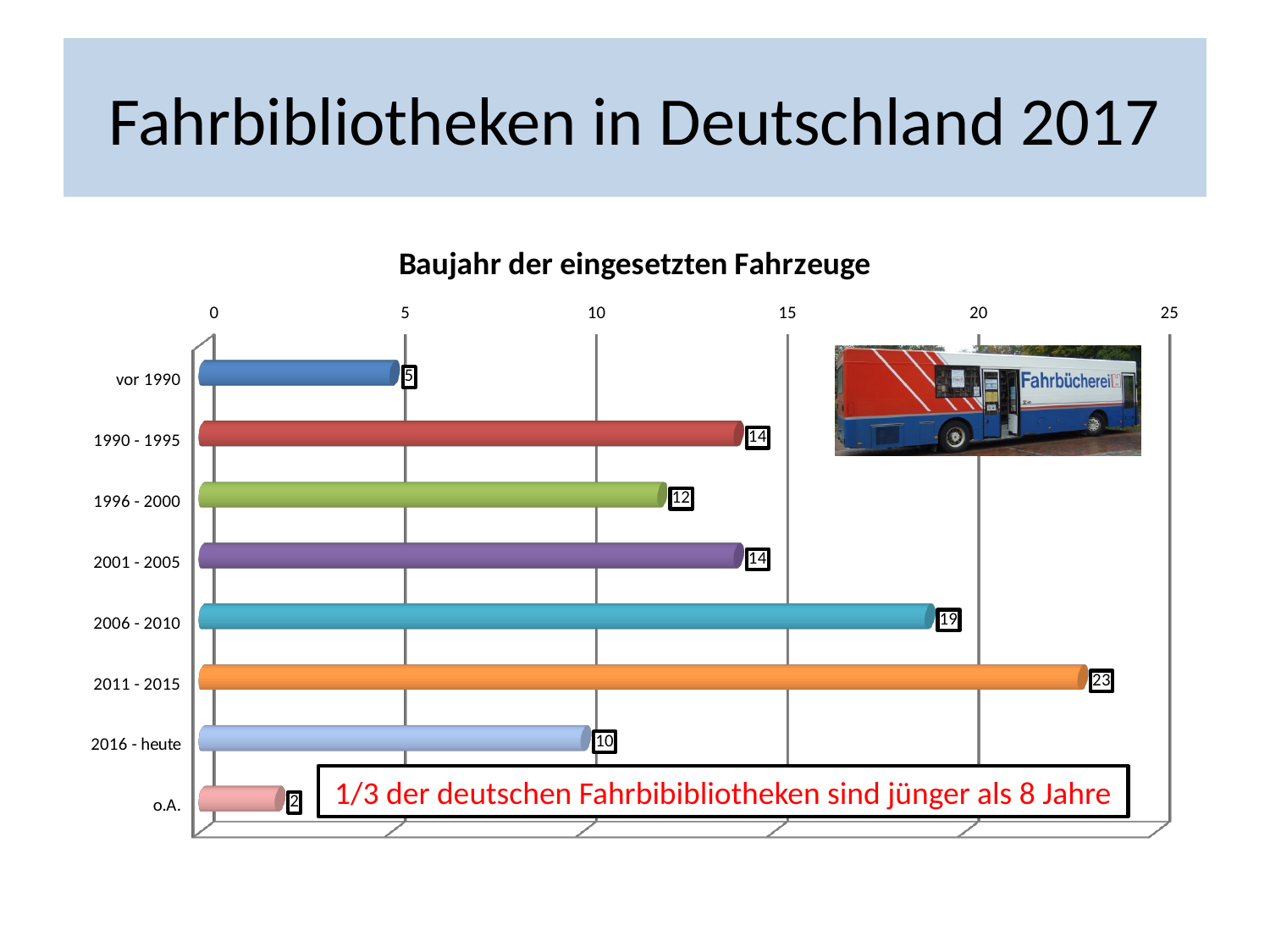
Is the value for 2006 - 2010 greater or less than 15? greater How many categories are shown in the chart? 8 What is the title of the chart? Baujahr der eingesetzten Fahrzeuge What is the value for the category 2016 - heute? 10 What is the difference between the values for 1990 - 1995 and 1996 - 2000? 2 Which category has the highest value? 2011 - 2015 What is the value for the category vor 1990? 5 What is the difference between the values for 2011 - 2015 and 2006 - 2010? 4 Which is larger, the value for 1996 - 2000 or the value for 2016 - heute? 1996 - 2000 What is the value for the category 2011 - 2015? 23 Which category has the lowest value? o.A. What kind of chart is shown on the slide? bar chart